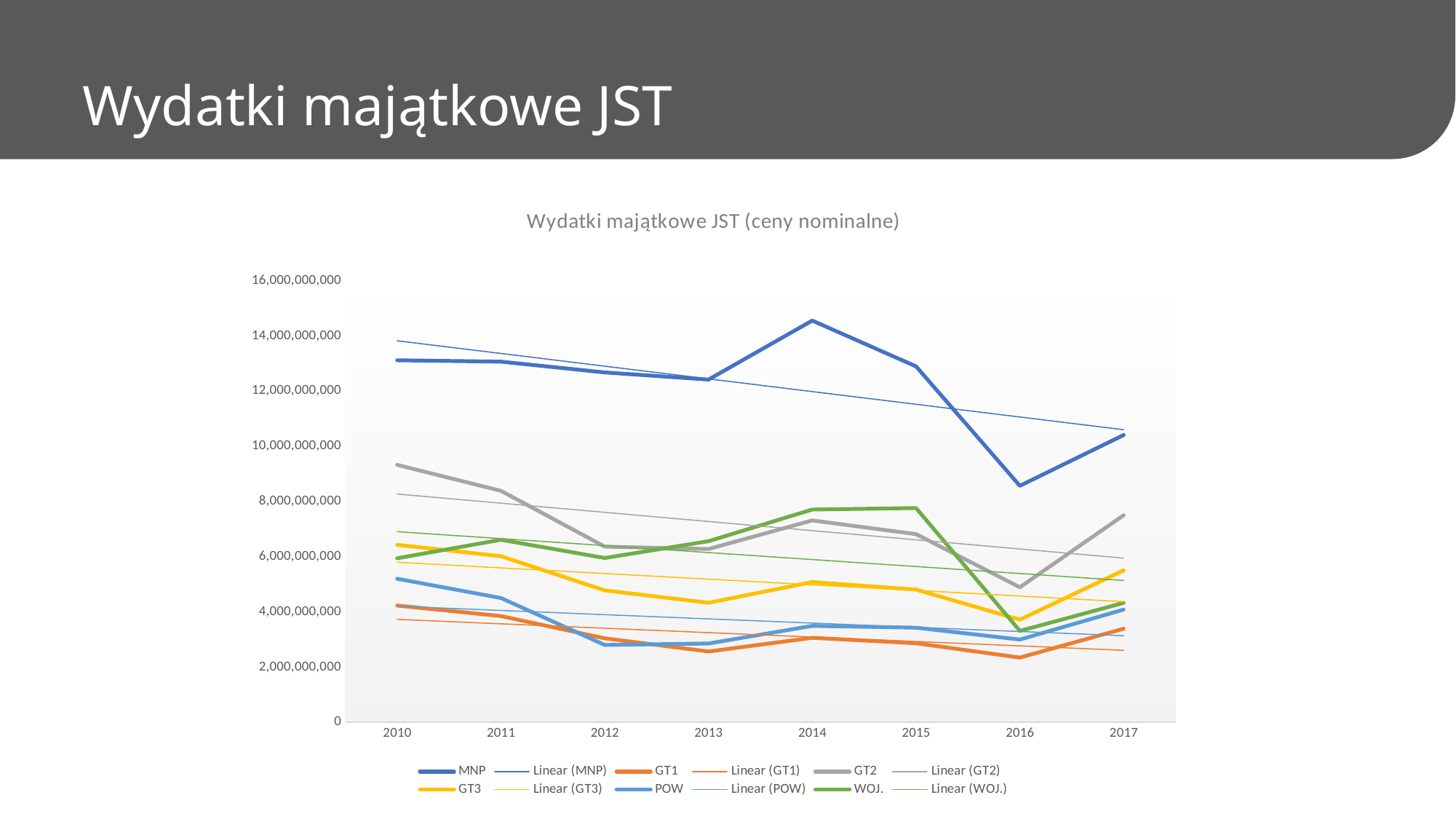
What kind of chart is shown on the slide? line chart In which year does the MNP series reach its lowest value? 2016 Is the value for MNP in 2016 greater or less than 10,000,000,000? less How many years are shown on the x axis? 8 Which series has the highest values across the whole chart? MNP How many entries does the chart legend list? 12 Does the Linear (MNP) trendline rise or fall from 2010 to 2017? fall What is the title of the chart? Wydatki majątkowe JST (ceny nominalne) Is the value for MNP in 2014 greater or less than 14,000,000,000? greater In 2015, which series has the larger value, WOJ. or GT3? WOJ. In which year does the MNP series reach its highest value? 2014 Is the value for GT1 in 2016 greater or less than 4,000,000,000? less